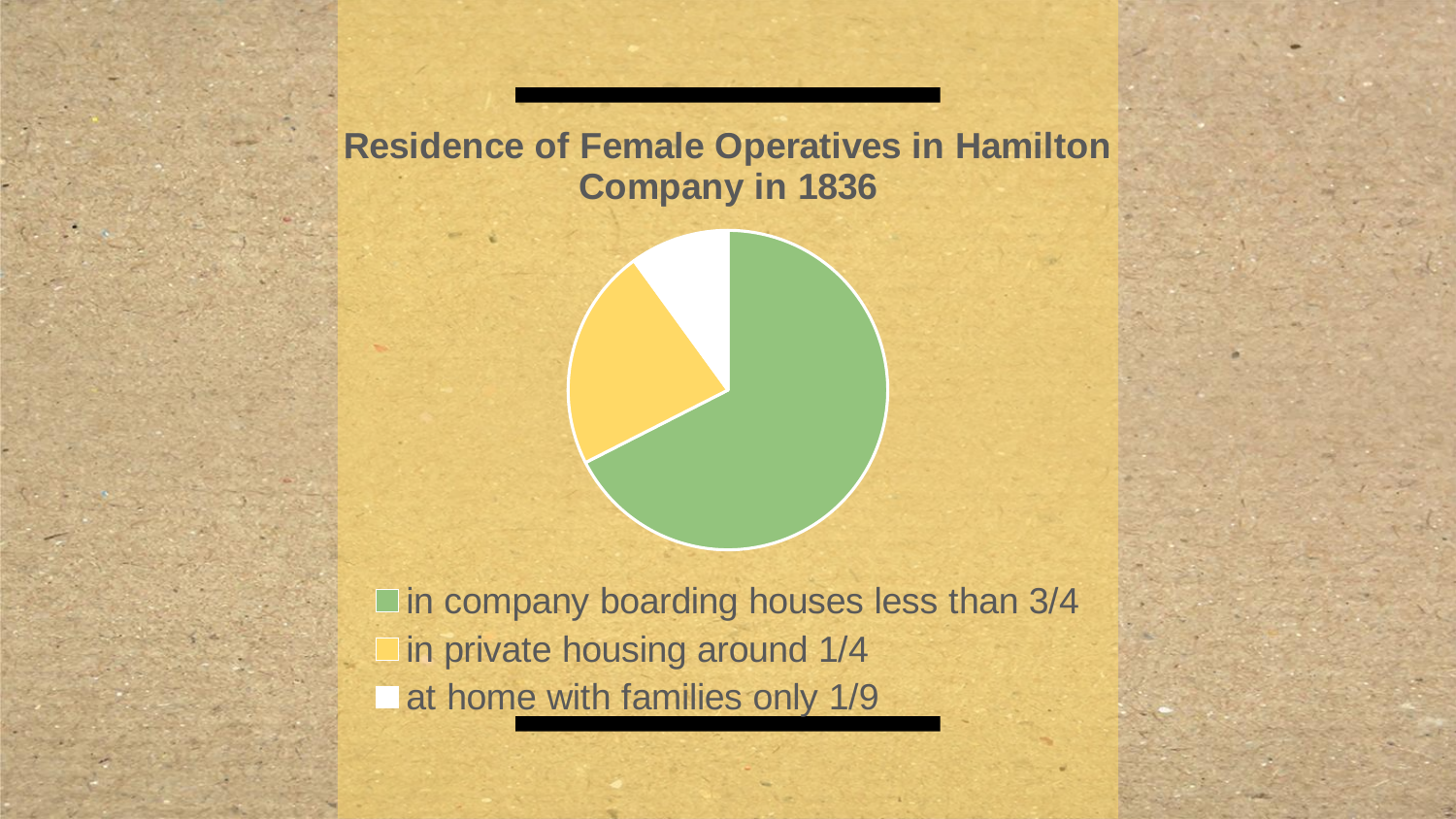
What kind of chart is shown on the slide? pie chart Which category has the smallest slice of the pie? at home with families only 1/9 What colour is the slice for in company boarding houses? green Which slice is larger: in private housing or at home with families? in private housing Which category has the largest slice of the pie? in company boarding houses less than 3/4 Which slice is larger: in company boarding houses or in private housing? in company boarding houses How many entries does the legend list? 3 How many slices does the pie chart have? 3 Which category is shown in yellow? in private housing around 1/4 What is the title of the chart? Residence of Female Operatives in Hamilton Company in 1836